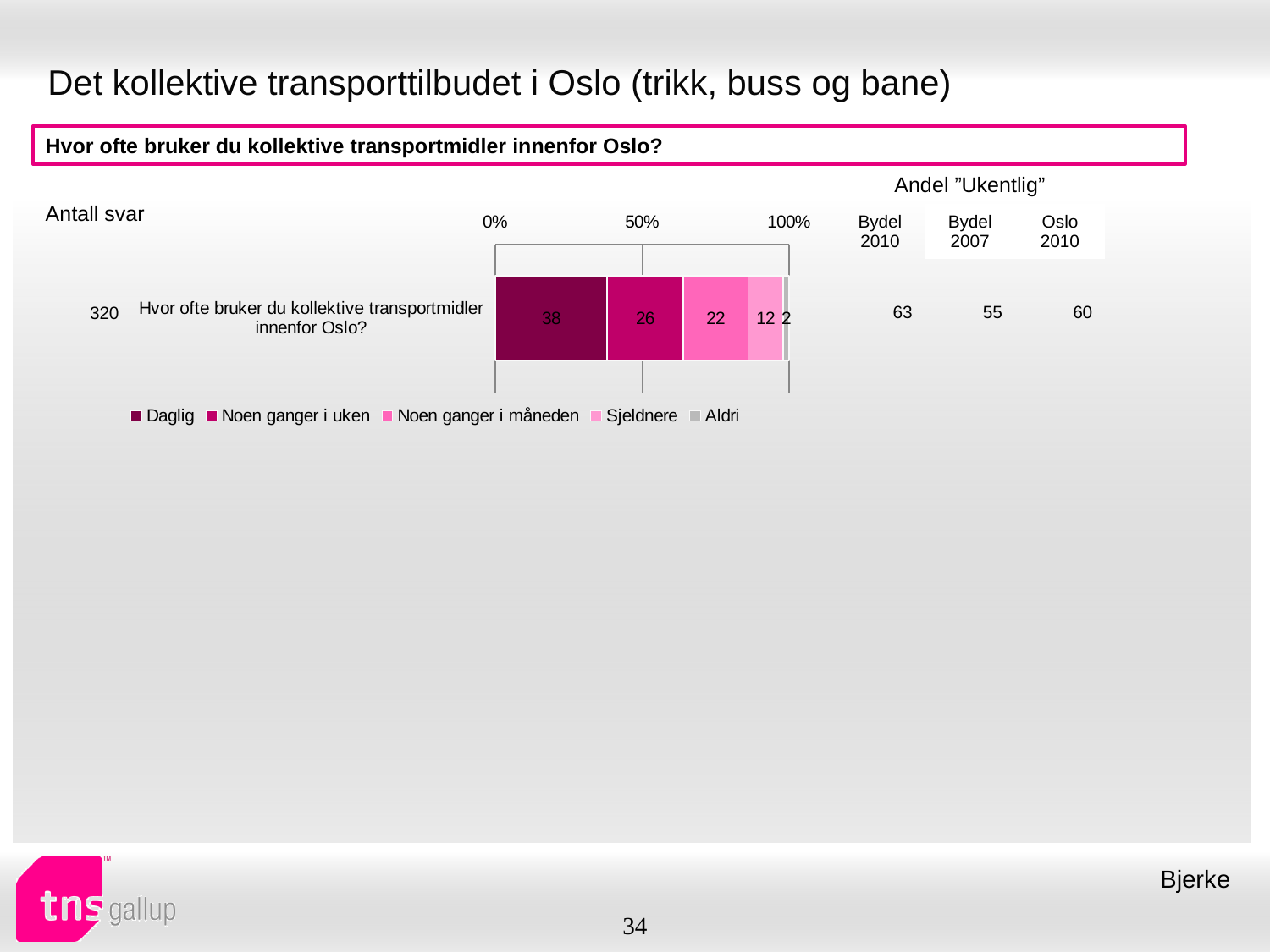
What is the value for "Sjeldnere" in the chart? 12 Which series has the largest segment in the stacked bar? Daglig What is the total of all segments in the stacked bar? 100 What is the value for "Noen ganger i uken" in the chart? 26 What is the value for "Noen ganger i måneden" in the chart? 22 Which is larger, the value for "Noen ganger i måneden" or the value for "Sjeldnere"? Noen ganger i måneden What is the difference between the "Daglig" and "Noen ganger i uken" values? 12 What is the value for "Daglig" in the chart? 38 What is the value for "Aldri" in the chart? 2 Which series has the smallest segment in the stacked bar? Aldri What kind of chart is shown on the slide? Stacked bar chart How many series does the chart legend list? 5